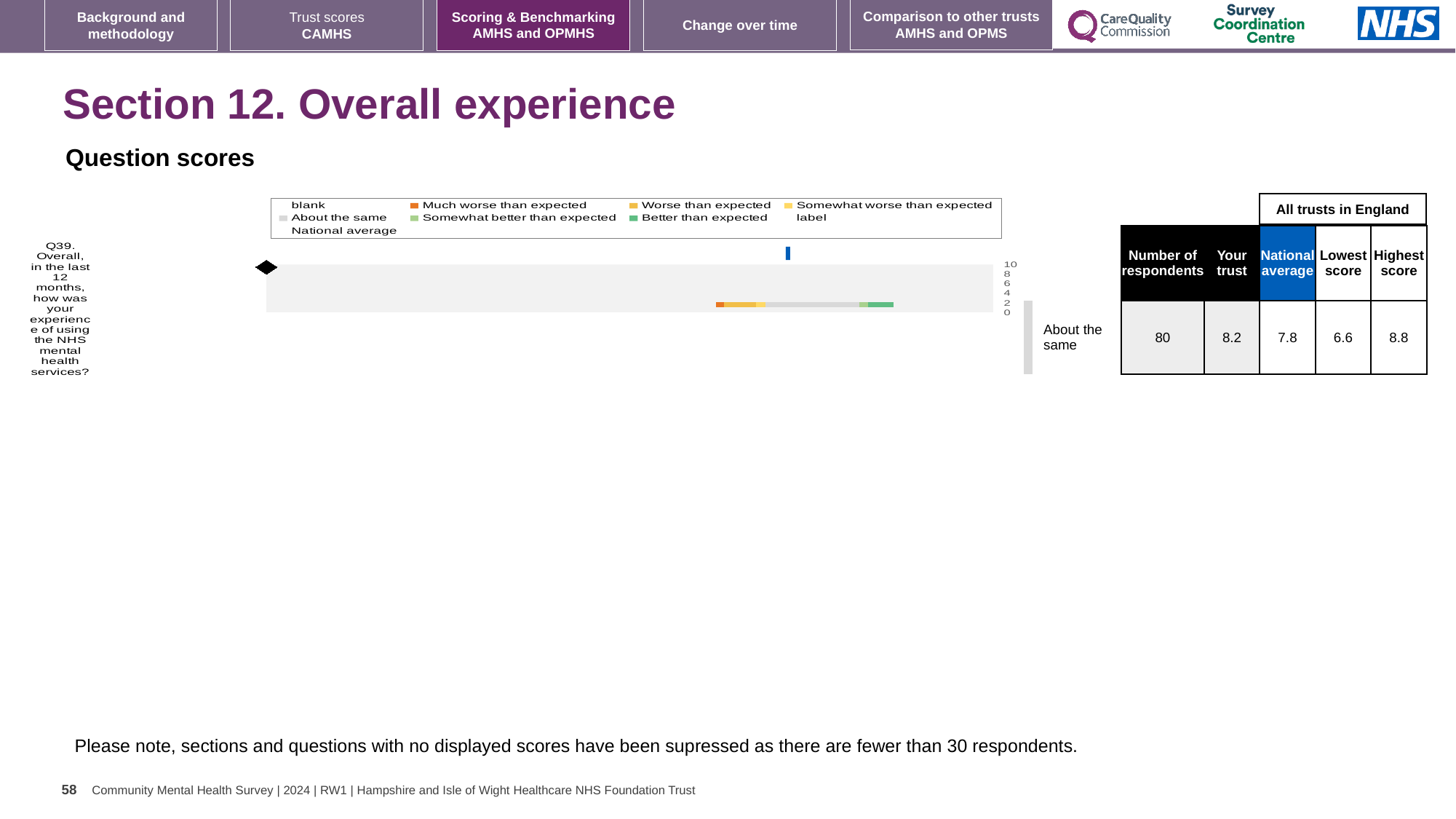
By how much does the 'Your trust' score for Q39 exceed the national average? 0.4 What is the difference between the highest and lowest trust scores for Q39? 2.2 What is the lowest score among all trusts in England for Q39? 6.6 What type of chart is used to show the Q39 question score? bar chart How many respondents answered Q39? 80 Which question number is plotted in the Question scores chart? Q39 How many survey questions are plotted in the Question scores chart? 1 What is the highest score among all trusts in England for Q39? 8.8 Which is higher for Q39: the 'Your trust' score or the national average? Your trust What is the national average score for Q39? 7.8 Which benchmark category is the trust's Q39 score placed in? About the same What is the 'Your trust' score for Q39? 8.2